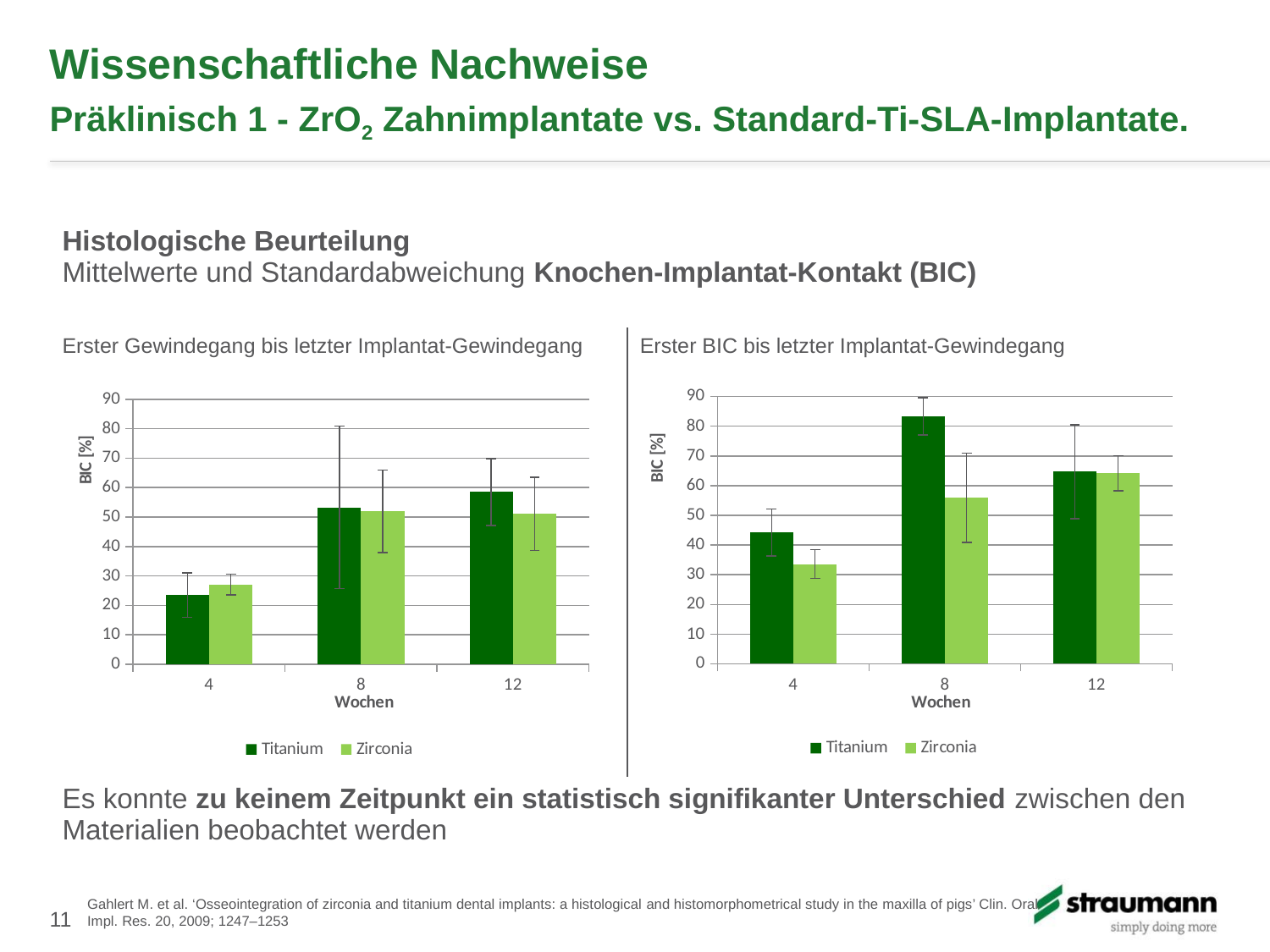
How many week categories are shown on the x axis of the left chart, 'Erster Gewindegang bis letzter Implantat-Gewindegang'? 3 In the left chart, 'Erster Gewindegang bis letzter Implantat-Gewindegang', is the Titanium value at 12 weeks greater or less than 50? greater In the right chart, 'Erster BIC bis letzter Implantat-Gewindegang', is the Titanium value at 8 weeks greater or less than 80? greater What kind of chart is the left chart, 'Erster Gewindegang bis letzter Implantat-Gewindegang'? bar chart In the right chart, 'Erster BIC bis letzter Implantat-Gewindegang', which is larger at 8 weeks, Titanium or Zirconia? Titanium In the left chart, 'Erster Gewindegang bis letzter Implantat-Gewindegang', at which week is the Zirconia bar lowest? 4 What is the label of the y axis on the right chart, 'Erster BIC bis letzter Implantat-Gewindegang'? BIC [%] How many series does the legend of the right chart, 'Erster BIC bis letzter Implantat-Gewindegang', list? 2 In the right chart, 'Erster BIC bis letzter Implantat-Gewindegang', at which week is the Titanium bar highest? 8 In the left chart, 'Erster Gewindegang bis letzter Implantat-Gewindegang', is the Titanium value at 4 weeks greater or less than 30? less In the left chart, 'Erster Gewindegang bis letzter Implantat-Gewindegang', do the Titanium values rise or fall from 4 to 12 weeks? rise